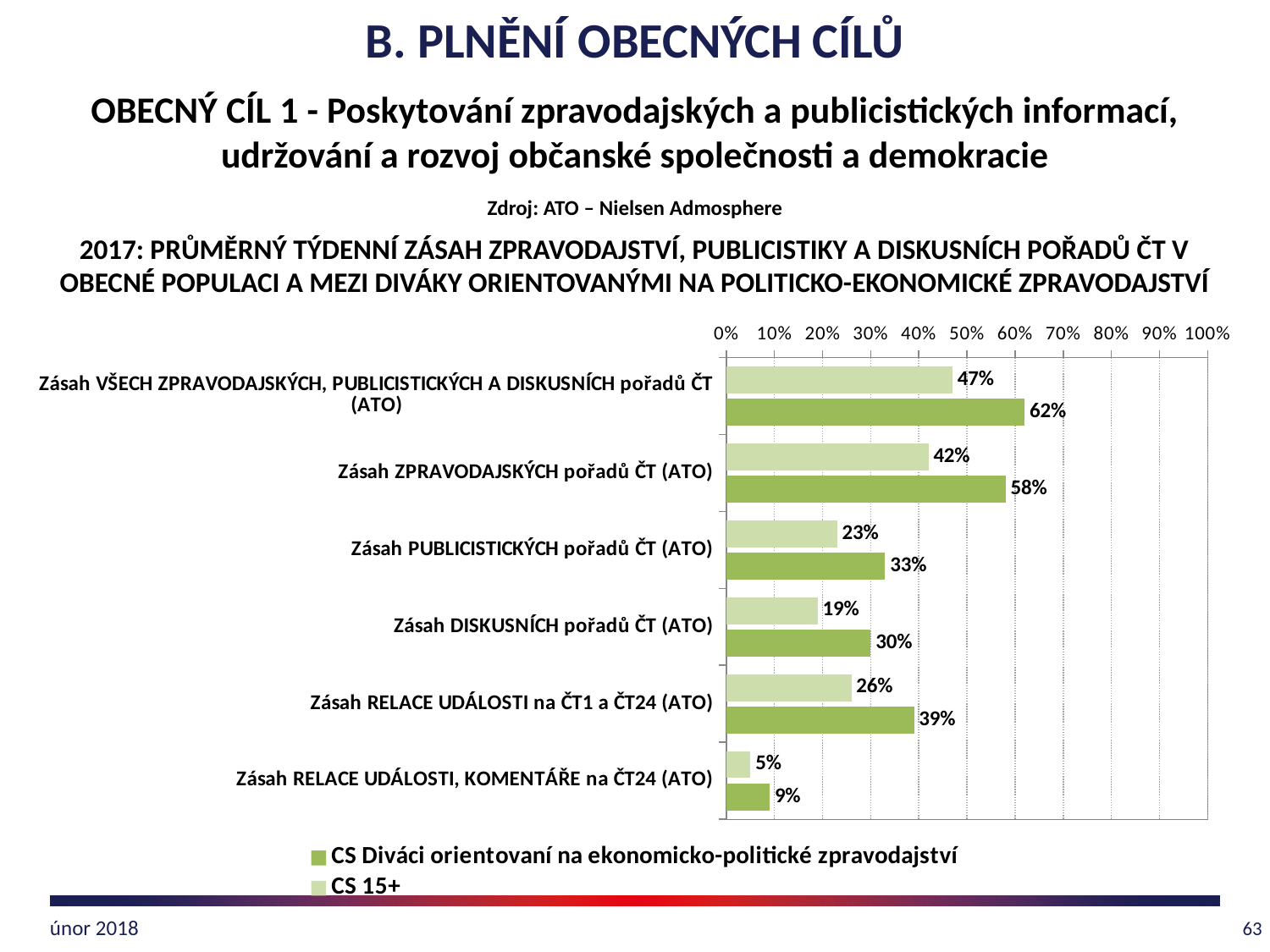
How many categories are shown on the chart? 6 Is the 'CS Diváci orientovaní na ekonomicko-politické zpravodajství' value for 'Zásah VŠECH ZPRAVODAJSKÝCH, PUBLICISTICKÝCH A DISKUSNÍCH pořadů ČT (ATO)' greater or less than 60%? greater What is the difference between the two series for 'Zásah PUBLICISTICKÝCH pořadů ČT (ATO)'? 10% What is the value for 'CS Diváci orientovaní na ekonomicko-politické zpravodajství' for 'Zásah DISKUSNÍCH pořadů ČT (ATO)'? 30% How many series does the legend list? 2 What is the value for CS 15+ for 'Zásah ZPRAVODAJSKÝCH pořadů ČT (ATO)'? 42% Which is larger: the CS 15+ value for 'Zásah DISKUSNÍCH pořadů ČT (ATO)' or for 'Zásah RELACE UDÁLOSTI na ČT1 a ČT24 (ATO)'? Zásah RELACE UDÁLOSTI na ČT1 a ČT24 (ATO) What kind of chart is shown on the slide? bar chart Which category has the highest value for 'CS Diváci orientovaní na ekonomicko-politické zpravodajství'? Zásah VŠECH ZPRAVODAJSKÝCH, PUBLICISTICKÝCH A DISKUSNÍCH pořadů ČT (ATO) Which category has the lowest value for CS 15+? Zásah RELACE UDÁLOSTI, KOMENTÁŘE na ČT24 (ATO) What is the value for CS 15+ for 'Zásah RELACE UDÁLOSTI, KOMENTÁŘE na ČT24 (ATO)'? 5% What is the difference between the 'CS Diváci orientovaní na ekonomicko-politické zpravodajství' values for 'Zásah ZPRAVODAJSKÝCH pořadů ČT (ATO)' and 'Zásah RELACE UDÁLOSTI na ČT1 a ČT24 (ATO)'? 19%